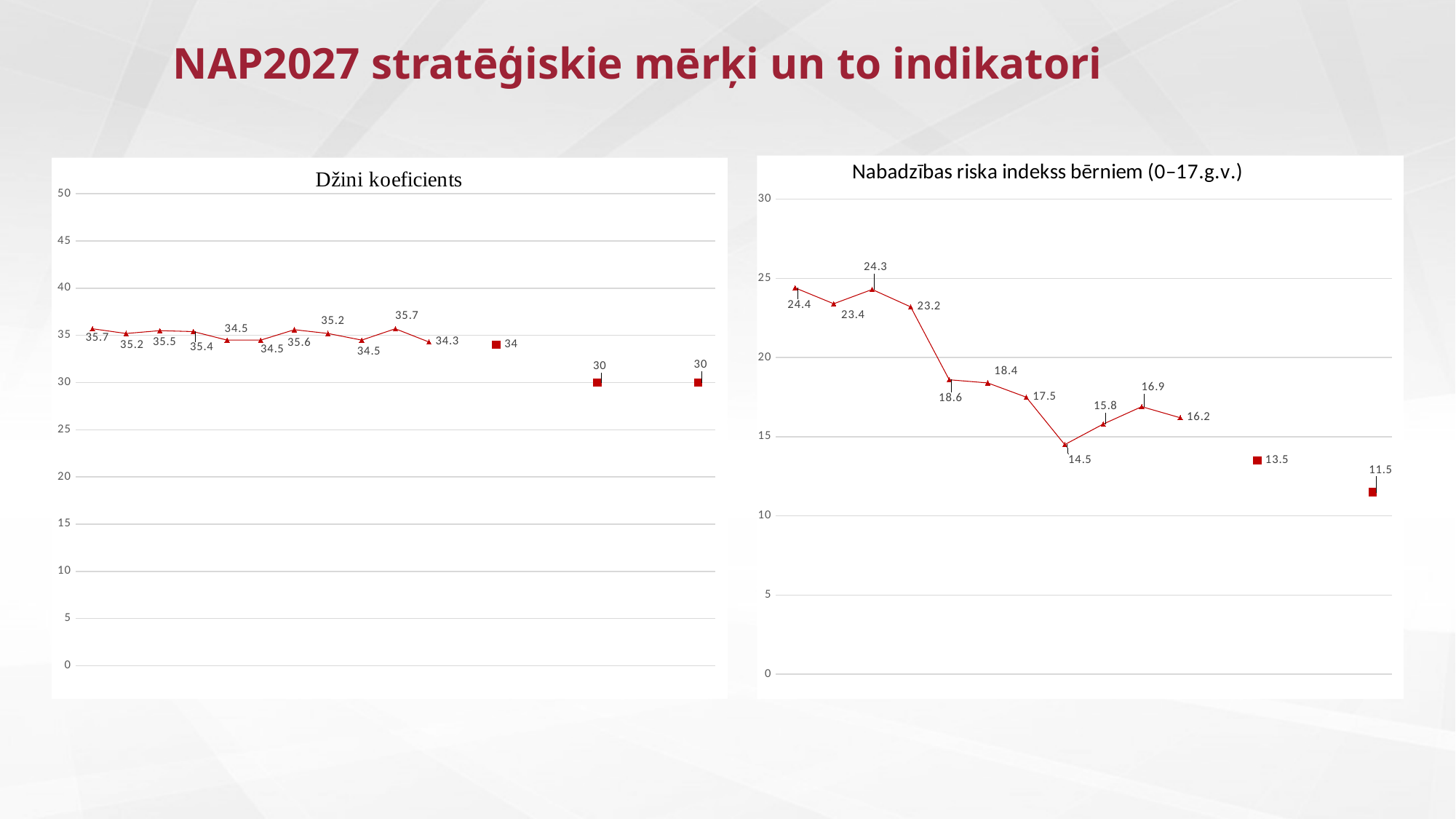
On the chart titled "Nabadzības riska indekss bērniem (0–17.g.v.)", what is the value of the last point on the line? 16.2 On the chart titled "Nabadzības riska indekss bērniem (0–17.g.v.)", what is the value of the rightmost square marker? 11.5 On the chart titled "Nabadzības riska indekss bērniem (0–17.g.v.)", what is the highest value labelled on the line? 24.4 On the chart titled "Nabadzības riska indekss bērniem (0–17.g.v.)", do the values on the line generally rise or fall from left to right? fall On the chart titled "Džini koeficients", is the value of the square marker labelled 34 greater or less than 35? less On the chart titled "Džini koeficients", how many points are plotted on the line? 11 On the chart titled "Džini koeficients", what is the value of the last point on the line? 34.3 What kind of chart is the chart titled "Džini koeficients"? line chart On the chart titled "Džini koeficients", what value is labelled on the two rightmost square markers? 30 On the chart titled "Nabadzības riska indekss bērniem (0–17.g.v.)", what is the difference between the first point on the line (24.4) and the last point on the line (16.2)? 8.2 On the chart titled "Nabadzības riska indekss bērniem (0–17.g.v.)", what is the lowest value labelled on the line? 14.5 What is the title of the chart on the left side of the slide? Džini koeficients